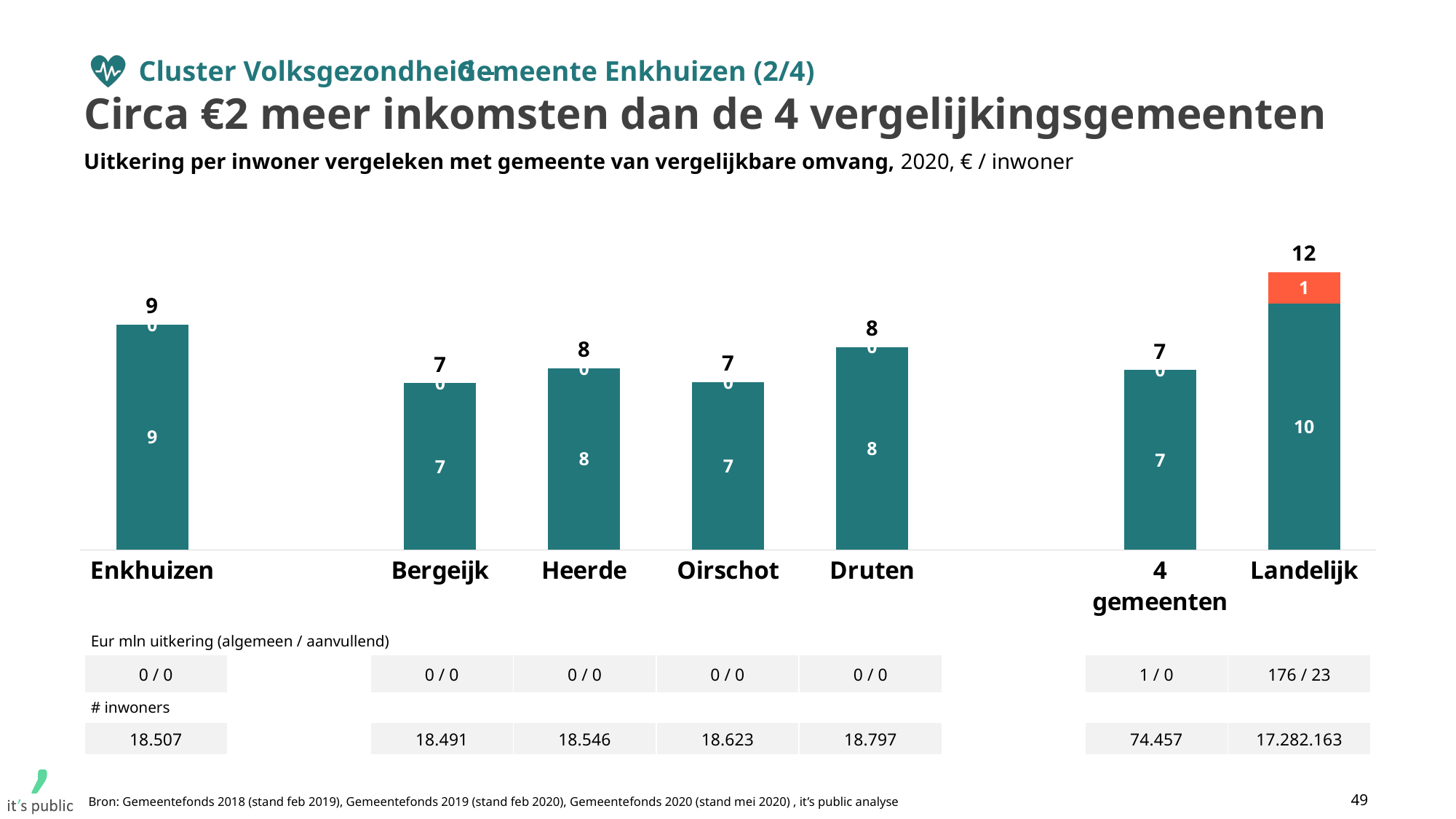
What is the value of the teal (bottom) segment of the Landelijk bar? 10 What is the number of inhabitants (# inwoners) listed for Enkhuizen below the chart? 18.507 Which has a higher total value, Enkhuizen or Heerde? Enkhuizen What is the total value shown above the bar for Landelijk? 12 What is the total value shown above the bar for Druten? 8 What is the total value shown above the bar for Enkhuizen? 9 What is the total value shown above the bar for 4 gemeenten? 7 What is the difference between the total for Enkhuizen and the total for 4 gemeenten? 2 How many categories are shown on the x axis of the chart? 7 Which category has the highest total value? Landelijk What is the value of the orange (top) segment of the Landelijk bar? 1 What kind of chart is shown on the slide? Stacked bar chart